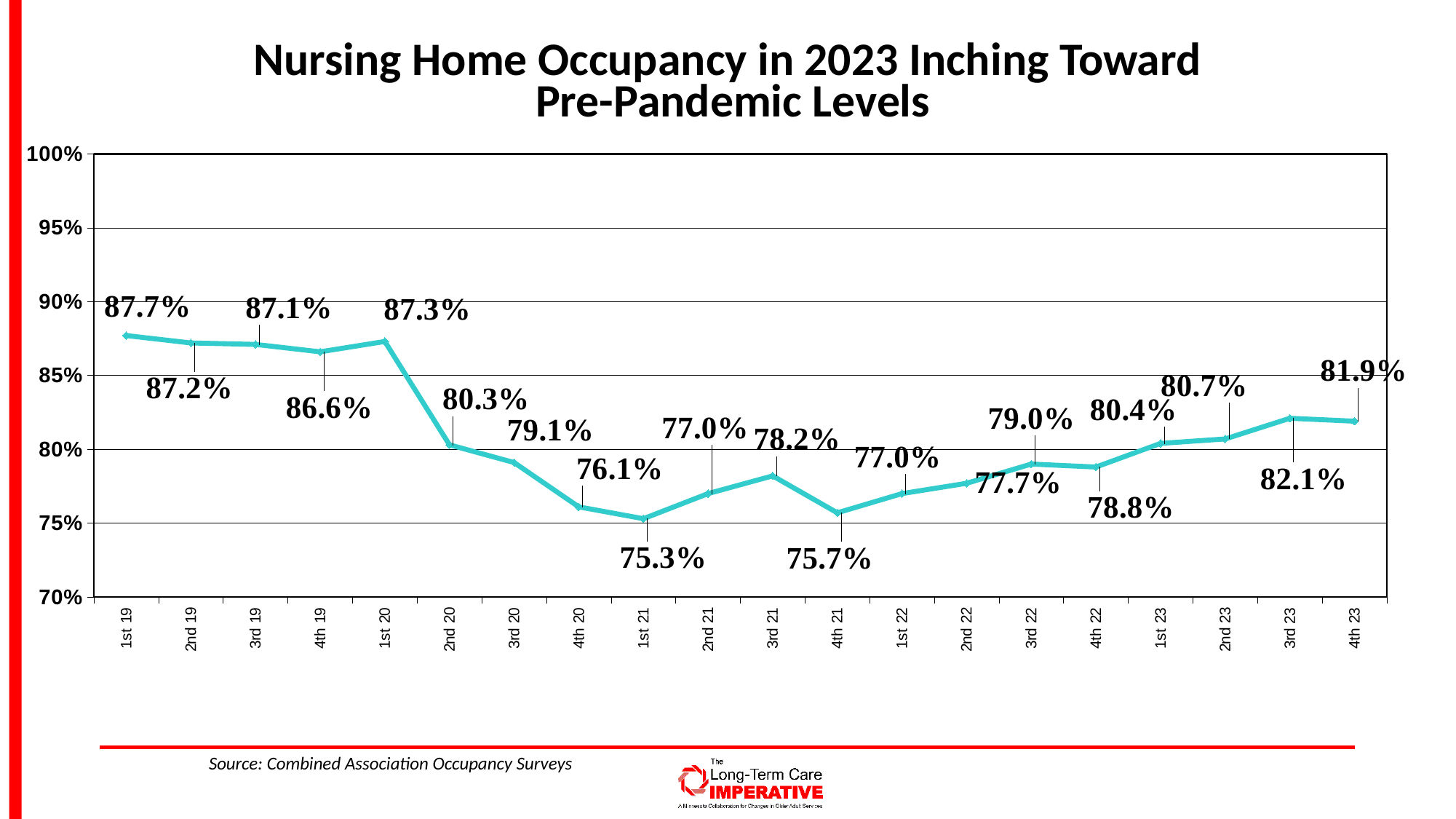
What is the occupancy value for 2nd 20? 80.3% How many quarters are plotted on the chart? 20 Which quarter has the lowest occupancy value? 1st 21 What is the occupancy value for 1st 21? 75.3% What kind of chart is shown on the slide? Line chart What is the nursing home occupancy value for 1st 19? 87.7% Do the occupancy values rise or fall from 1st 22 to 3rd 23? Rise What is the difference between the occupancy values for 3rd 23 and 4th 23? 0.2% Which quarter has the highest occupancy value? 1st 19 Which is larger, the occupancy value for 3rd 21 or for 4th 21? 3rd 21 What is the occupancy value for 4th 23? 81.9% What is the difference between the occupancy values for 1st 20 and 2nd 20? 7.0%